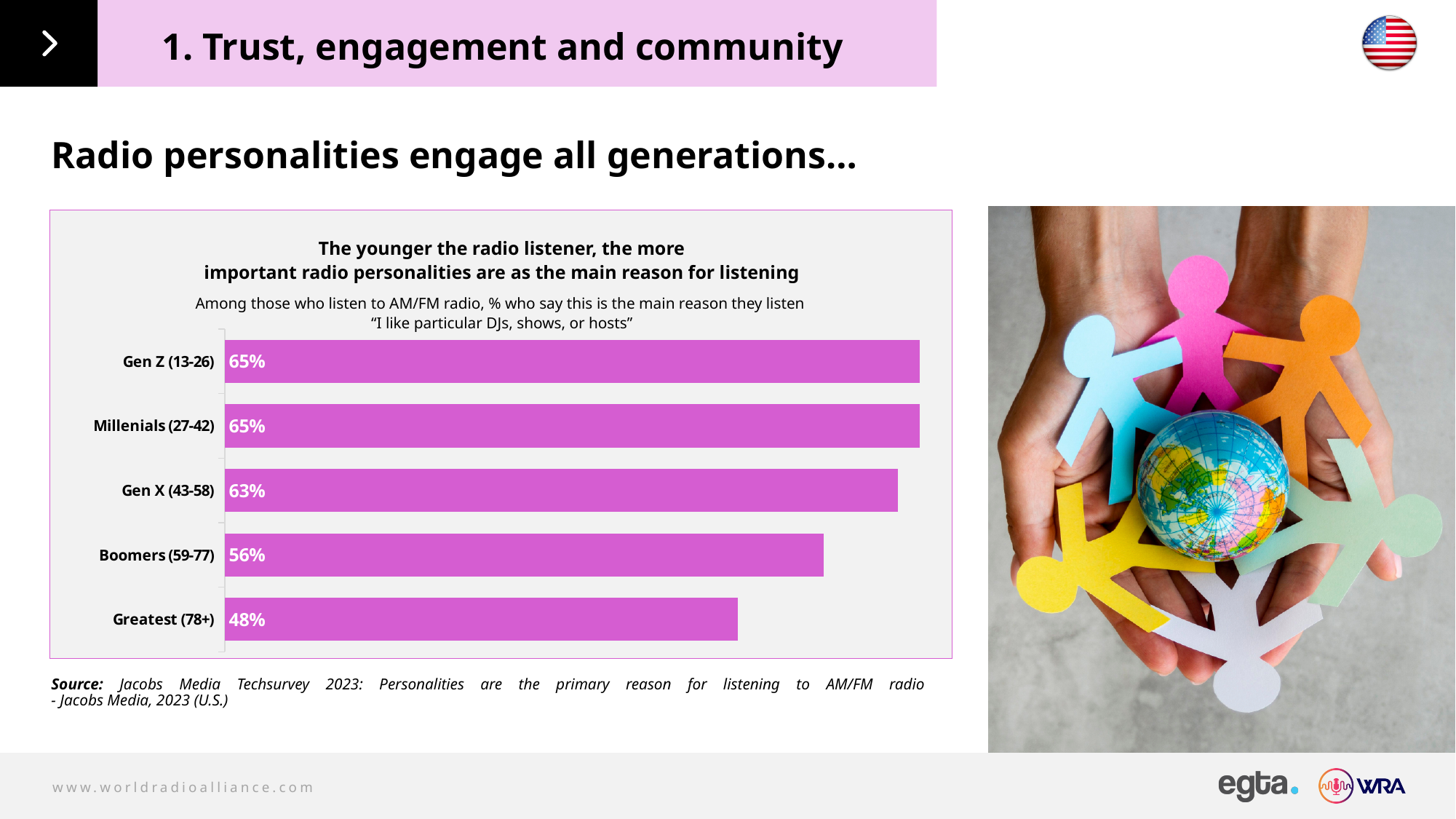
What is the difference between the values for Gen Z (13-26) and Greatest (78+)? 17 percentage points What is the value shown for Greatest (78+)? 48% Which generation has the lowest value in the chart? Greatest (78+) What is the value shown for Boomers (59-77)? 56% Do the values rise or fall as the generations get older, moving down the chart? Fall What is the value shown for Gen X (43-58)? 63% What kind of chart is shown on the slide? Bar chart What is the title of the chart? The younger the radio listener, the more important radio personalities are as the main reason for listening What is the difference between the values for Gen X (43-58) and Boomers (59-77)? 7 percentage points What percentage of Gen Z (13-26) listeners say they like particular DJs, shows, or hosts as the main reason they listen? 65% How many generation categories are shown in the chart? 5 Which is larger, the value for Boomers (59-77) or the value for Greatest (78+)? Boomers (59-77)